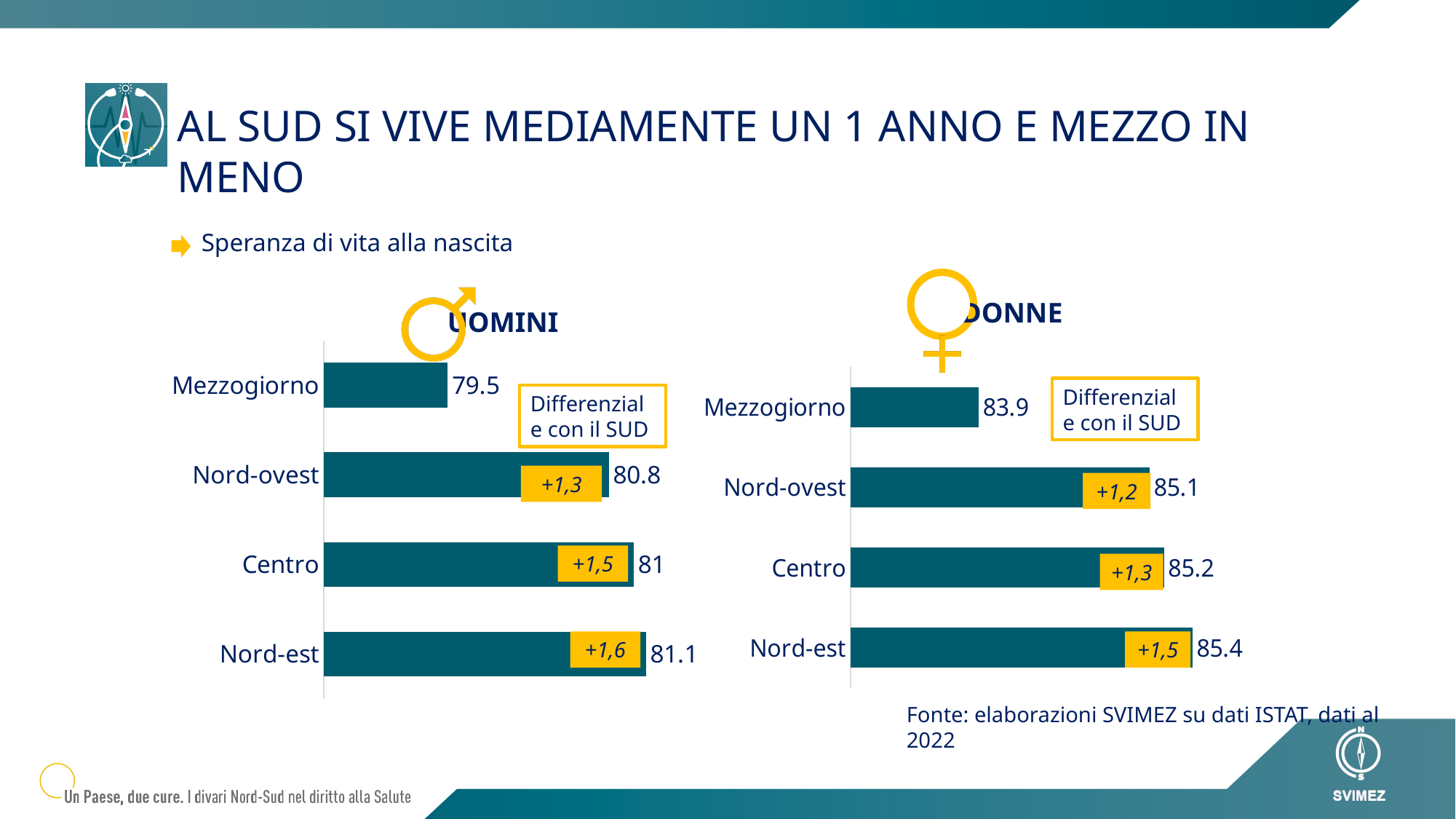
In the DONNE chart, what is the value for Nord-ovest? 85.1 In the DONNE chart, what is the value for Nord-est? 85.4 In the UOMINI chart, which region has the highest value? Nord-est What kind of chart is the DONNE chart? Bar chart How many regions are shown in the UOMINI chart? 4 In the UOMINI chart, what is the value for Mezzogiorno? 79.5 In the DONNE chart, which is larger, the value for Nord-ovest or the value for Centro? Centro In the UOMINI chart, what is the value for Centro? 81 In the UOMINI chart, what differential with the South is shown for Nord-ovest? +1,3 In the DONNE chart, which region has the lowest value? Mezzogiorno In the DONNE chart, what is the difference between the values for Centro and Mezzogiorno? 1.3 In the UOMINI chart, what is the difference between the values for Nord-est and Mezzogiorno? 1.6